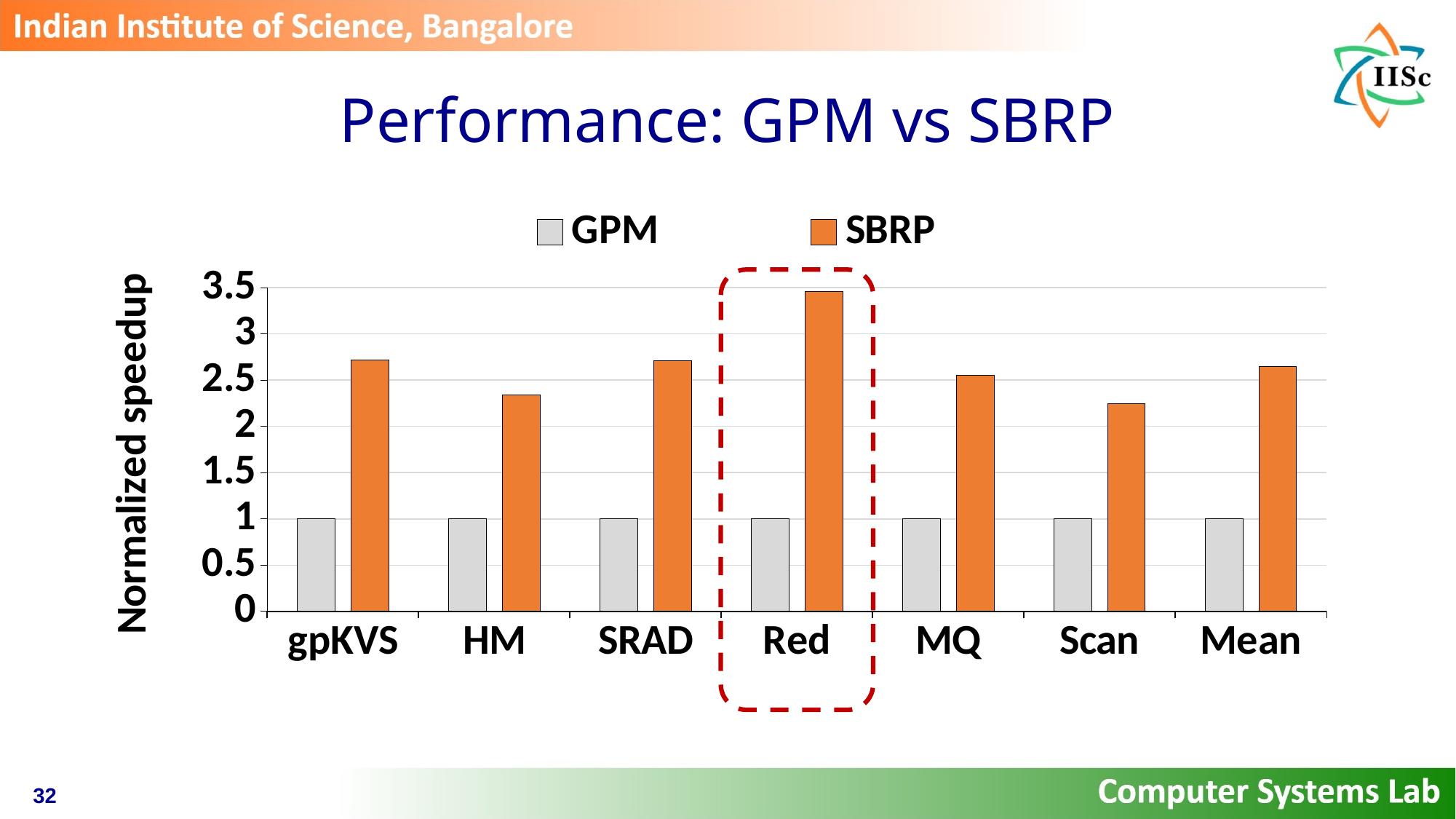
What is the GPM normalized speedup for Mean? 1 What is the GPM normalized speedup for gpKVS? 1 Is the SBRP value for Red greater or less than 3? greater Which category has the highest SBRP normalized speedup? Red How many categories are shown on the x axis? 7 What is the title of the chart on the slide? Performance: GPM vs SBRP What kind of chart is shown on the slide? bar chart Which series is shown in orange? SBRP Is the SBRP value for Scan greater or less than 2.5? less Which is larger, the SBRP value for Red or the SBRP value for HM? Red How many series does the legend list? 2 Is the SBRP value for gpKVS greater or less than 2.5? greater